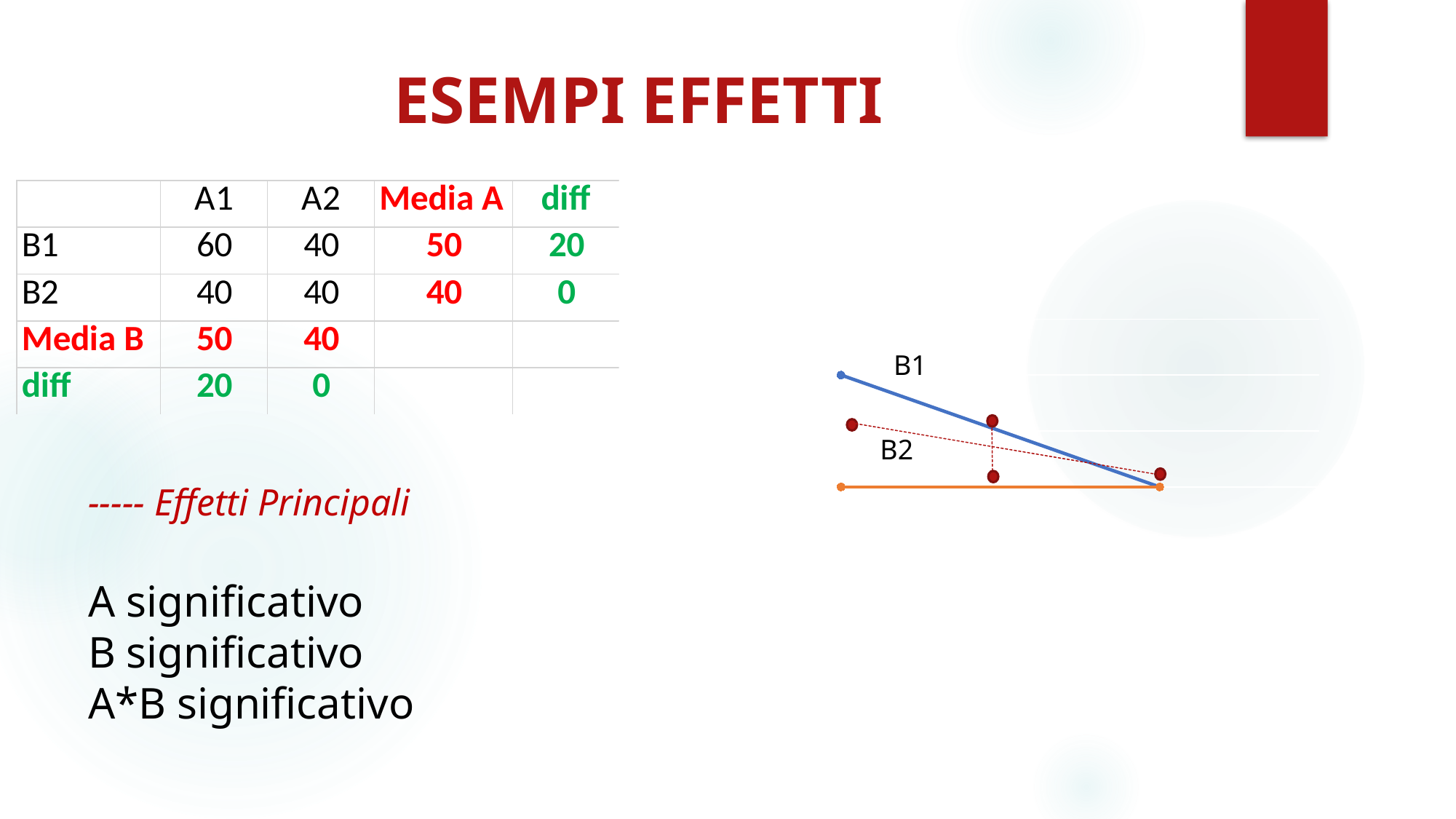
Does the B1 line rise or fall from left to right? fall Does the B2 line rise, fall or stay flat from left to right? stay flat At the left end of the chart, which line is higher, B1 or B2? B1 What are the labels of the two lines in the chart? B1 and B2 In the table, what is the difference (diff) between A1 and A2 for B1? 20 In the table, what is Media A for B2? 40 In the table, what is the value for B1 at A1? 60 How many labelled lines does the chart on the right show? 2 How many end points does each solid line in the chart have? 2 What kind of chart is shown on the right of the slide? line chart What colour is the B1 line in the chart? blue In the table, what is the value for B2 at A2? 40